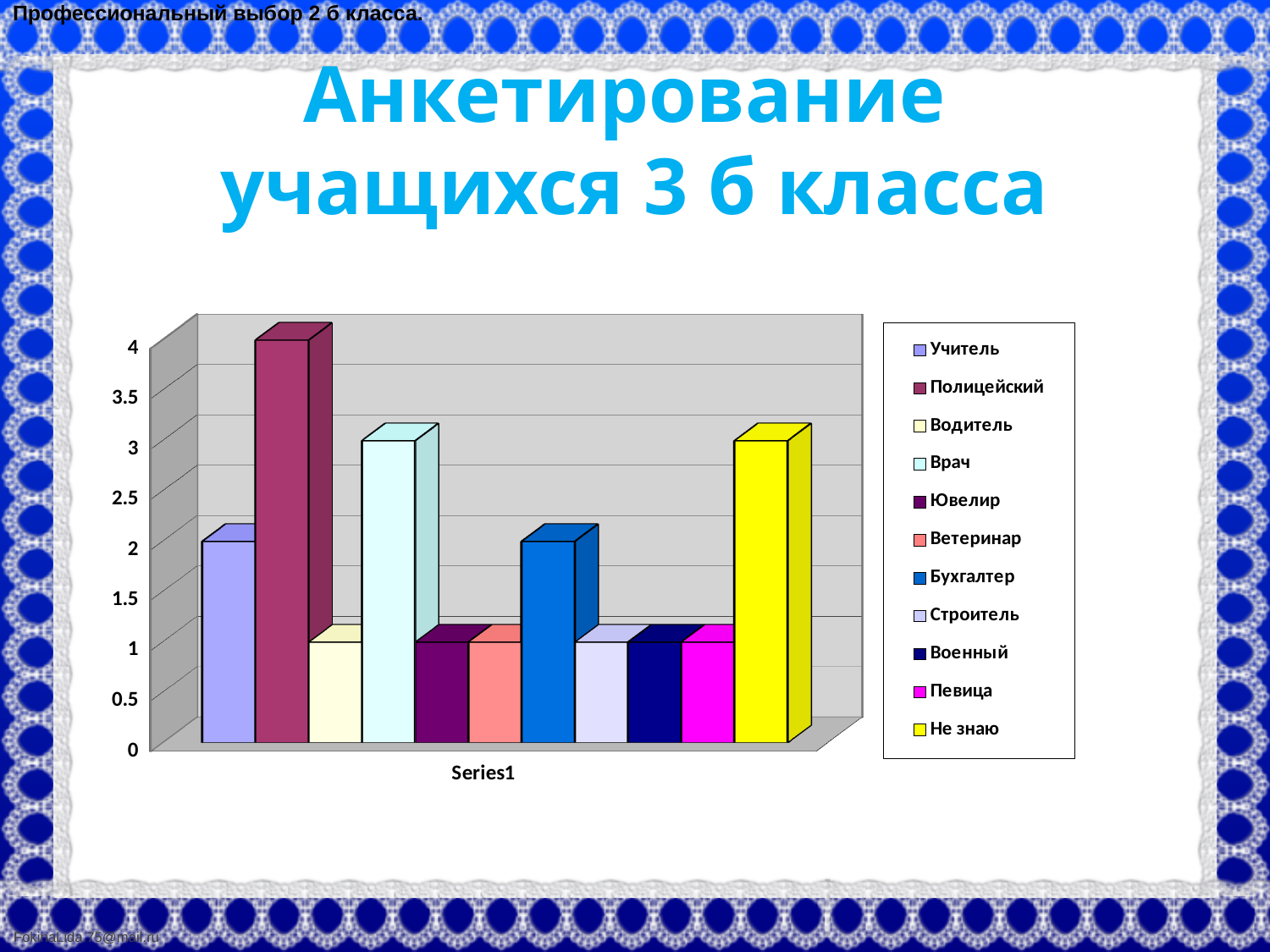
Is the value for Бухгалтер greater or less than 3? less How many bars are plotted in the chart? 11 How many entries does the chart legend list? 11 What is the title shown above the chart? Анкетирование учащихся 3 б класса What is the value for Врач? 3 What is the value for Не знаю? 3 What is the value for Учитель? 2 Which profession has the highest bar in the chart? Полицейский What is the value for Полицейский? 4 Which is larger, the value for Врач or the value for Учитель? Врач What is the difference between the values for Полицейский and Учитель? 2 What kind of chart is shown on the slide? bar chart